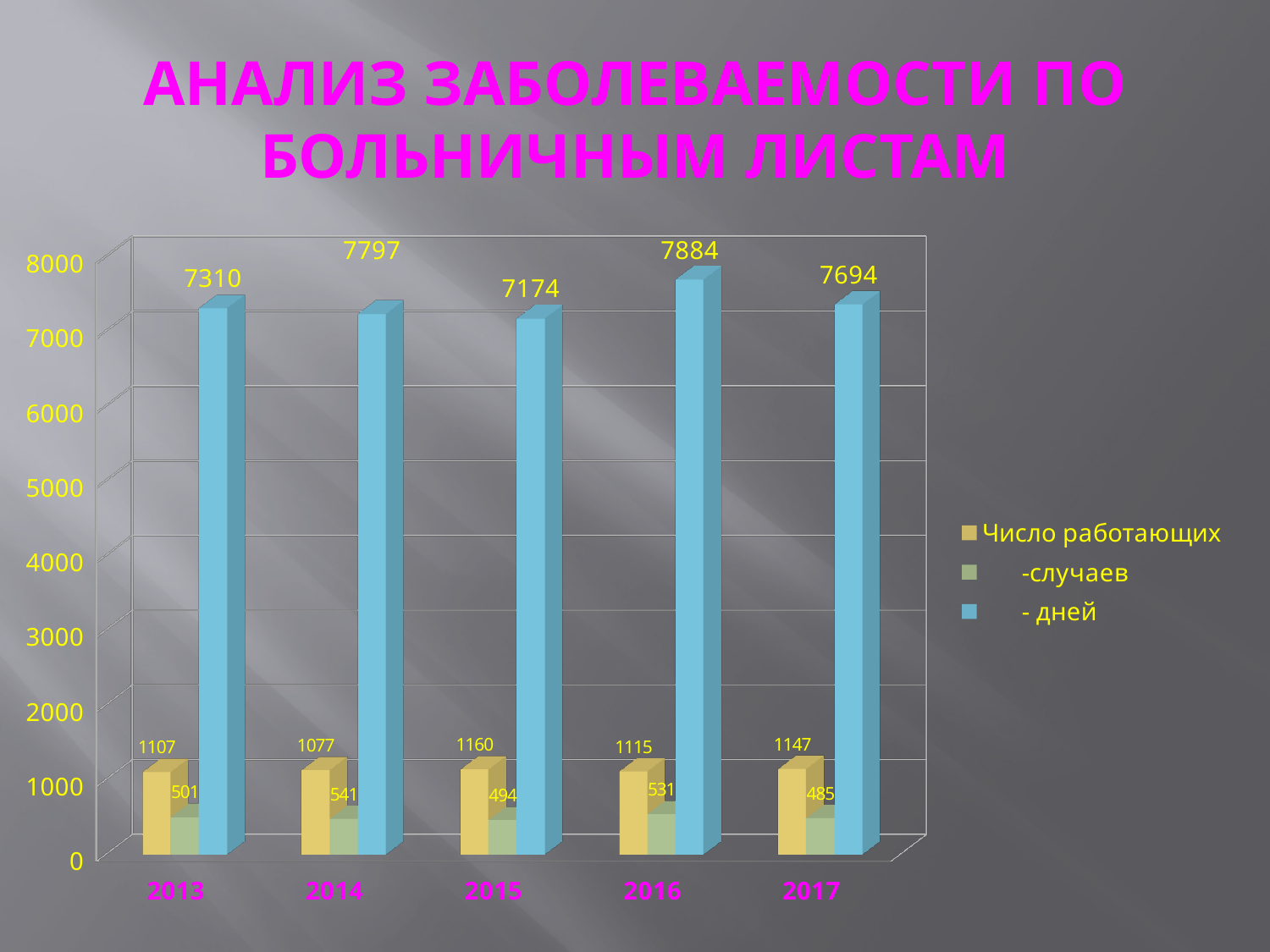
In which year is the value for "-случаев" the lowest? 2017 What kind of chart is shown on the slide? bar chart How many series does the legend list? 3 How many years are shown on the x axis? 5 What is the value for "Число работающих" in 2015? 1160 What is the value for "- дней" in 2016? 7884 What colour are the bars for the "- дней" series? blue In which year is the value for "- дней" the highest? 2016 Which is larger, the "Число работающих" value for 2013 or for 2014? 2013 What is the value for "-случаев" in 2014? 541 What is the difference between the "- дней" values for 2014 and 2013? 487 Is the value for "- дней" in 2015 greater or less than 7000? greater